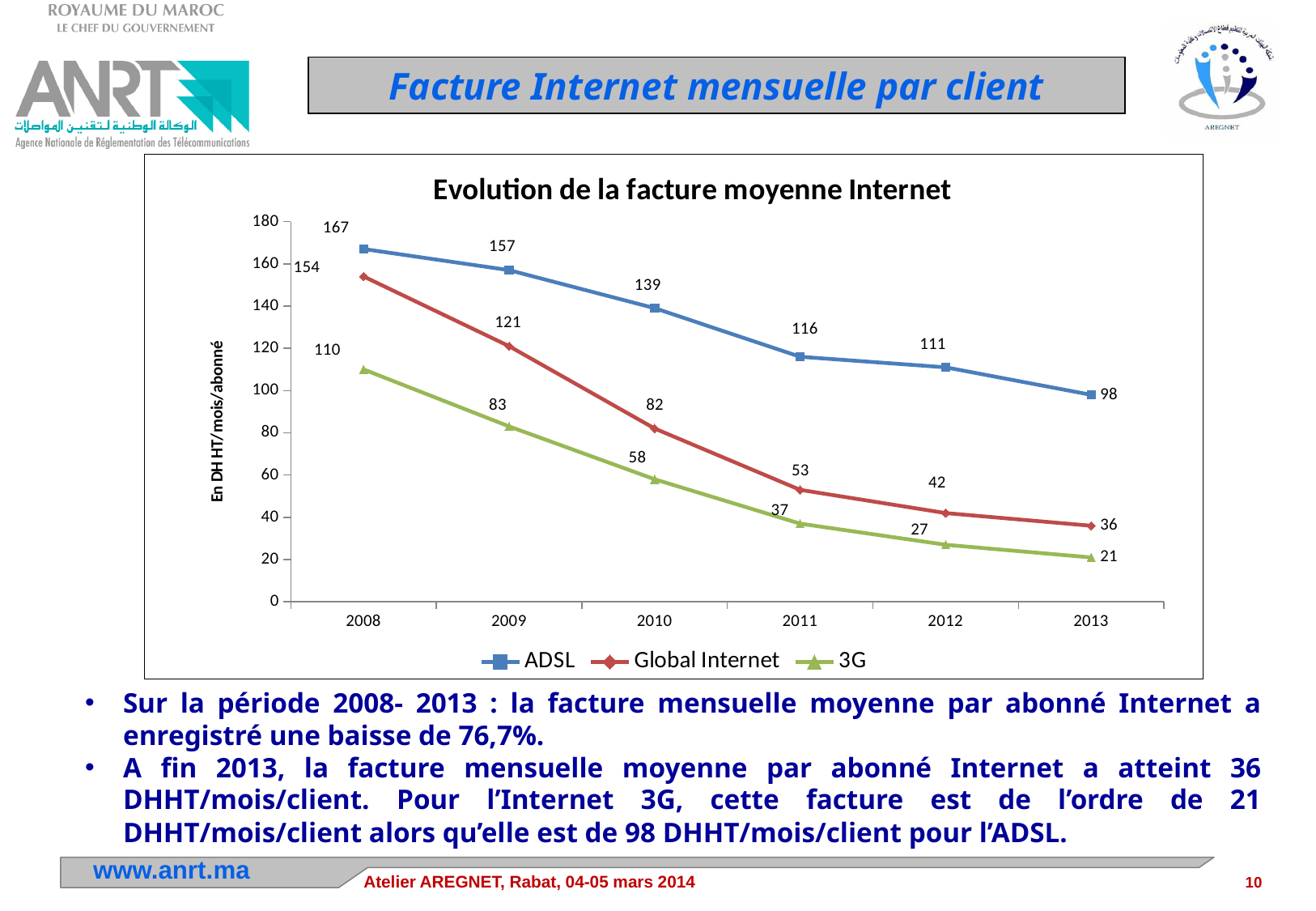
What is the value for Global Internet in 2010? 82 Do the Global Internet values rise or fall from 2008 to 2013? Fall How many years are shown on the x axis? 6 What kind of chart is this? Line chart What is the value for ADSL in 2008? 167 What is the difference between the ADSL value and the 3G value in 2011? 79 In which year is the ADSL value lowest? 2013 Which is larger in 2012: the Global Internet value or the 3G value? Global Internet How many series does the legend list? 3 What is the value for 3G in 2013? 21 In which year is the 3G value highest? 2008 What is the title of the chart? Evolution de la facture moyenne Internet